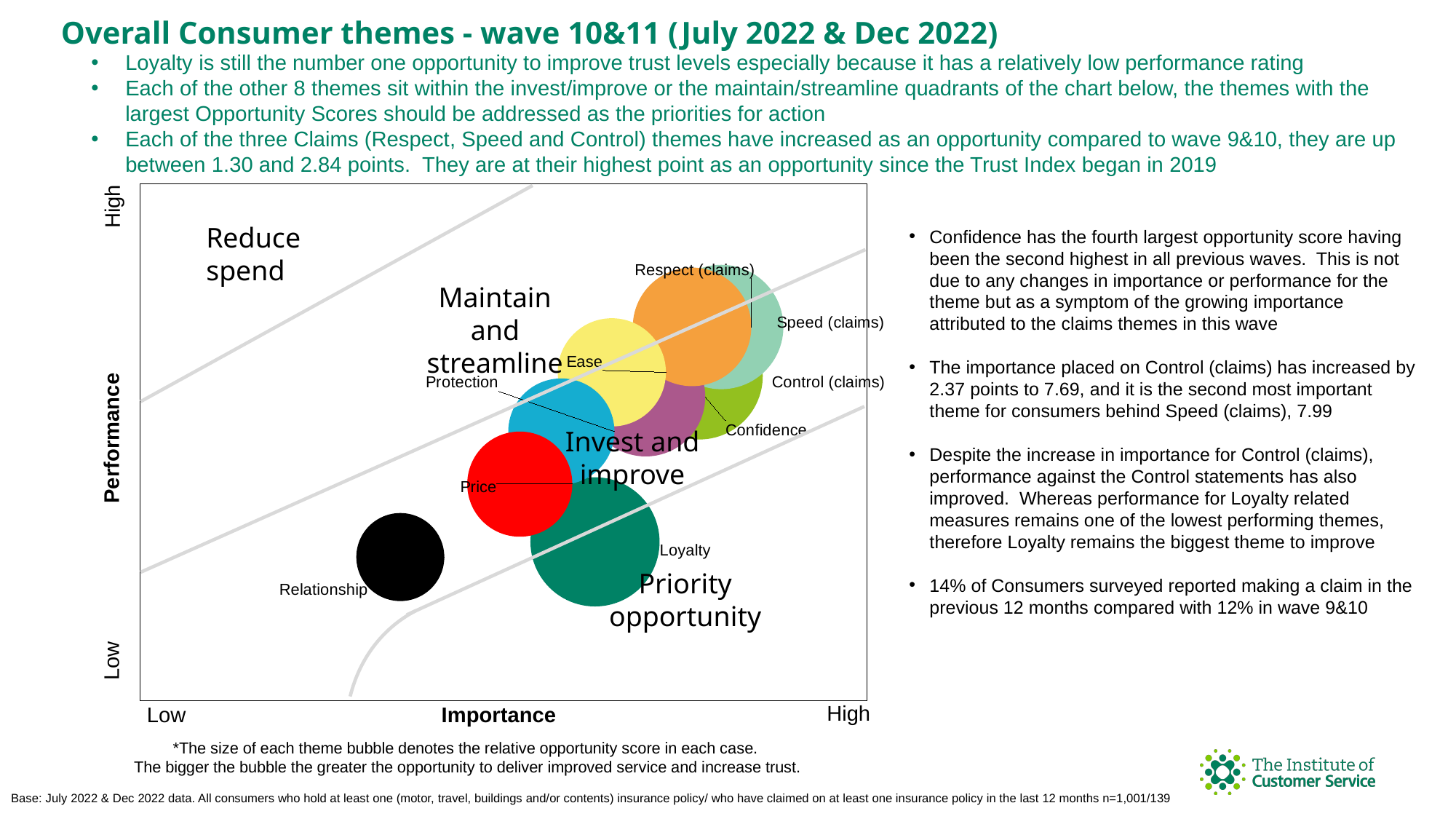
Which theme has the largest bubble on the chart? Loyalty What is the label of the horizontal axis of the chart? Importance Which bubble is larger, Loyalty or Relationship? Loyalty What kind of chart is shown on the slide? Bubble chart Which theme bubble is positioned furthest to the right on the Importance axis? Speed (claims) Which theme's bubble sits in the Priority opportunity area of the chart? Loyalty Which theme bubble is positioned furthest to the left on the Importance axis? Relationship Which bubble is larger, Price or Relationship? Price How many theme bubbles are plotted on the chart? 9 Which theme is plotted with a black bubble? Relationship